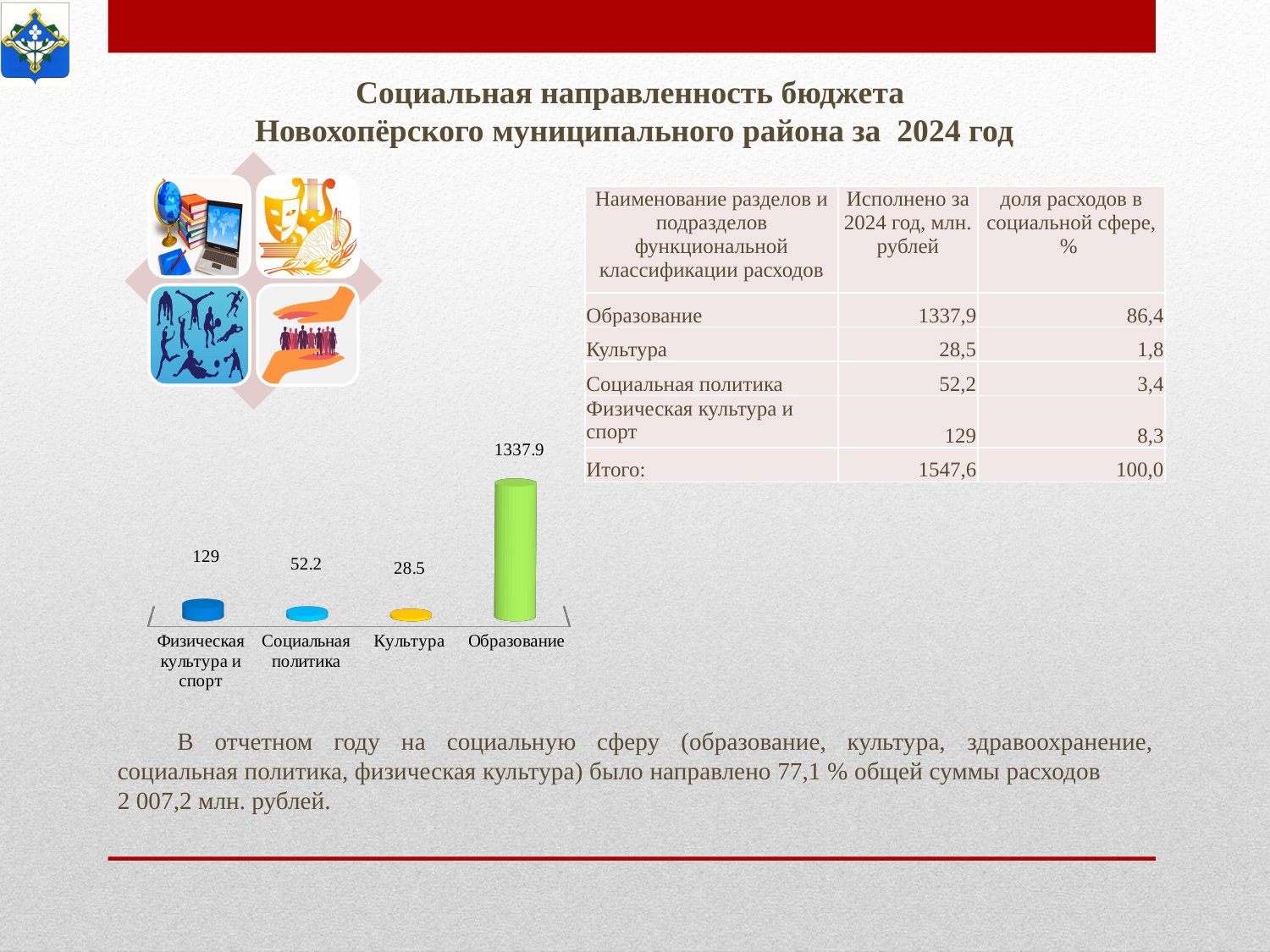
What kind of chart is shown on the slide? Bar chart What value is shown for Культура in the bar chart? 28.5 What colour is the bar for Образование in the chart? Green Which category has the highest value in the bar chart? Образование What is the difference between the values for Образование and Физическая культура и спорт in the bar chart? 1208.9 What value is shown for Физическая культура и спорт in the bar chart? 129 How many categories are shown in the bar chart? 4 Which category has the lowest value in the bar chart? Культура What is the difference between the values for Социальная политика and Культура in the bar chart? 23.7 What value is shown for Образование in the bar chart? 1337.9 What value is shown for Социальная политика in the bar chart? 52.2 Which is larger in the bar chart, the value for Физическая культура и спорт or the value for Социальная политика? Физическая культура и спорт